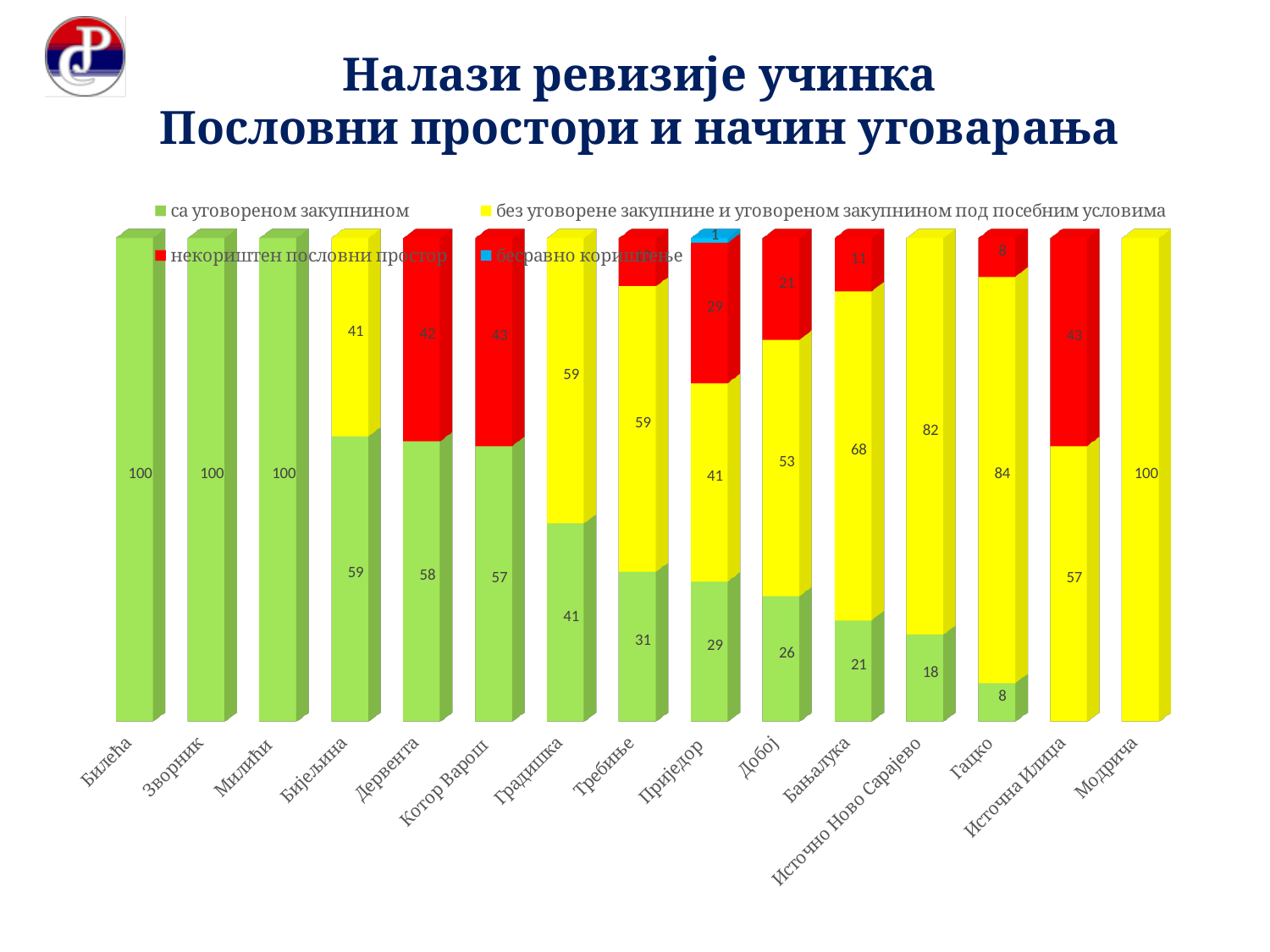
Which municipality has the lowest value for 'са уговореном закупнином' among those with a green segment? Гацко What is the value of 'бесправно коришћење' for Приједор? 1 What is the total of the stacked bar for Приједор? 100 How many categories (municipalities) are shown on the x axis? 15 What is the difference between the 'са уговореном закупнином' values for Градишка and Требиње? 10 How many series does the legend list? 4 Which municipality has the highest value for 'без уговорене закупнине и уговореном закупнином под посебним условима'? Модрича Which is larger: the 'некоришћен пословни простор' value for Добој or for Бањалука? Добој What is the value of 'без уговорене закупнине и уговореном закупнином под посебним условима' for Источно Ново Сарајево? 82 What is the value of 'некоришћен пословни простор' for Котор Варош? 43 What is the value of 'са уговореном закупнином' for Бијељина? 59 What kind of chart is shown on the slide? stacked bar chart